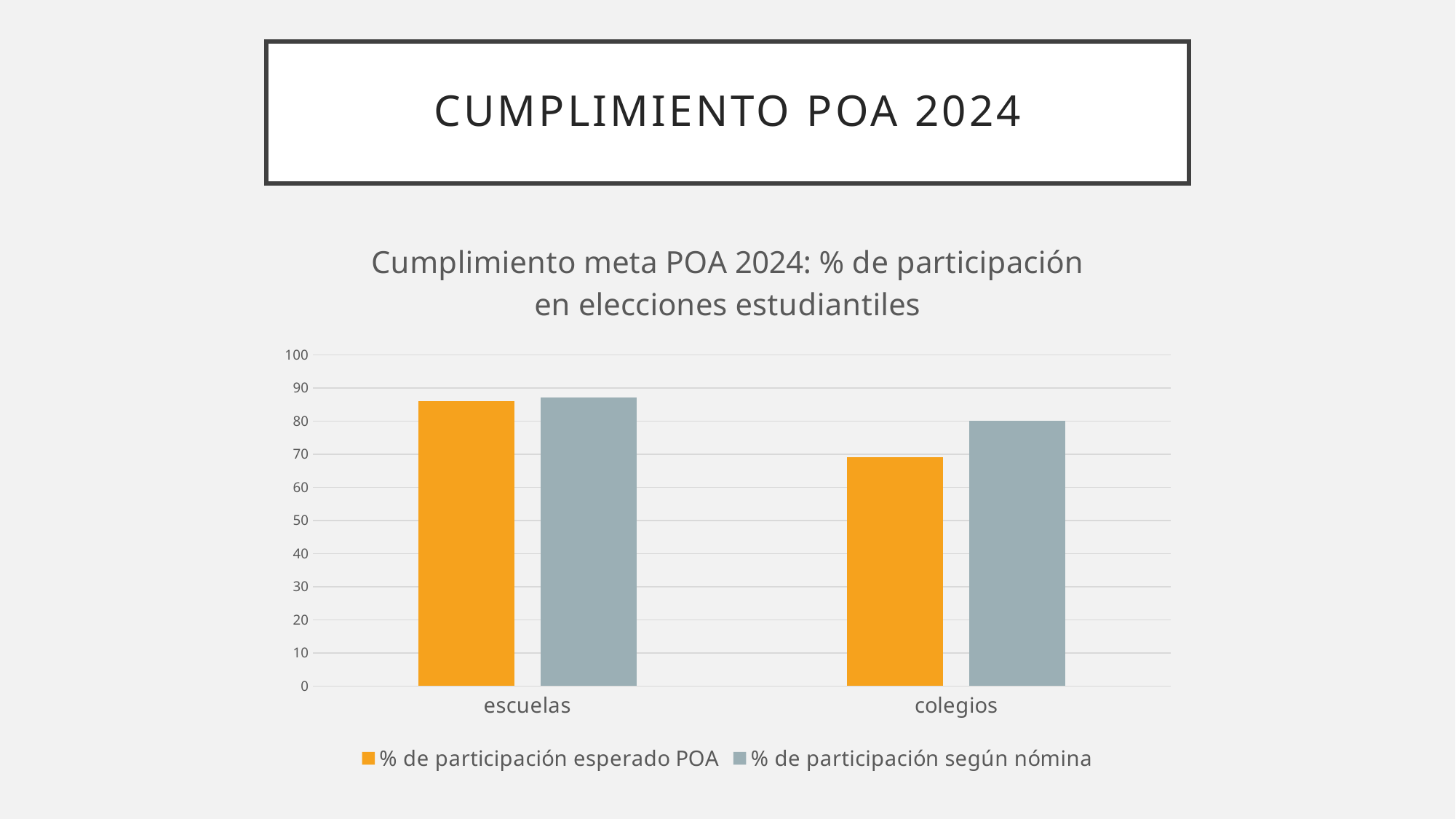
Is the value of '% de participación según nómina' for escuelas greater or less than 80? greater What kind of chart is shown on the slide? bar chart Is the value of '% de participación esperado POA' for colegios greater or less than 60? greater Is the value of '% de participación según nómina' for colegios greater or less than 70? greater Which category has the lowest value for '% de participación según nómina'? colegios How many categories are shown on the x axis of the chart? 2 Which colour represents '% de participación esperado POA' in the chart? orange Which category has the higher value for '% de participación esperado POA', escuelas or colegios? escuelas How many series does the chart's legend list? 2 For colegios, which series has the larger value: '% de participación esperado POA' or '% de participación según nómina'? % de participación según nómina